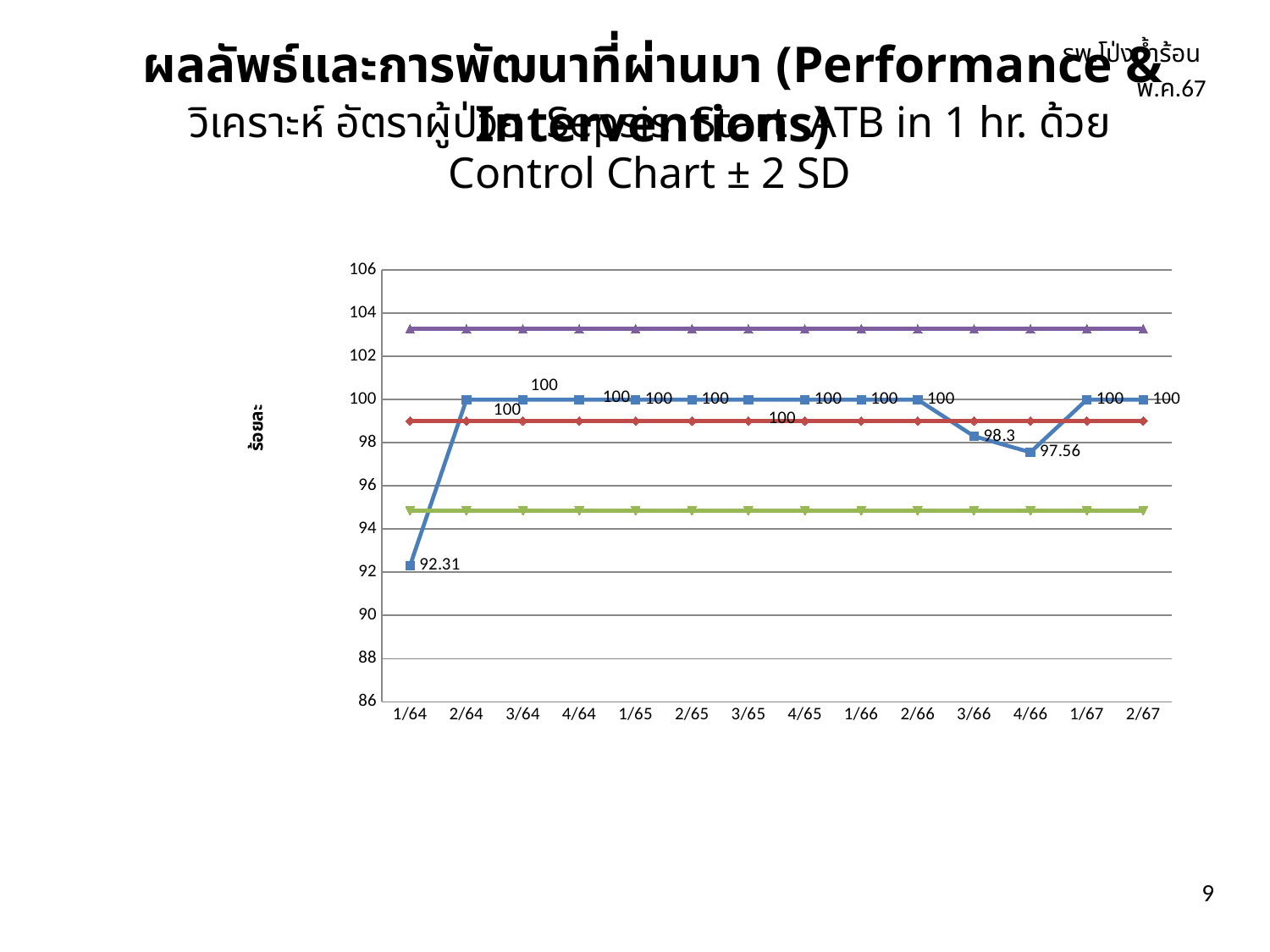
How many x-axis categories (time periods) are plotted on the chart? 14 What kind of chart is shown on the slide? line chart Which is larger for the blue series: the value at 3/66 or the value at 4/66? 3/66 What is the value of the blue data series at 4/66? 97.56 What is the value of the blue data series at 2/67? 100 At which x-axis category does the blue data series reach its lowest value? 1/64 What is the value of the blue data series at 1/64? 92.31 What is the value of the blue data series at 3/66? 98.3 Is the value of the purple line at 1/65 greater or less than 102? greater What is the label on the vertical axis of the chart? ร้อยละ What is the difference between the blue series values at 2/64 and 1/64? 7.69 Is the value of the green line at 1/65 greater or less than 96? less